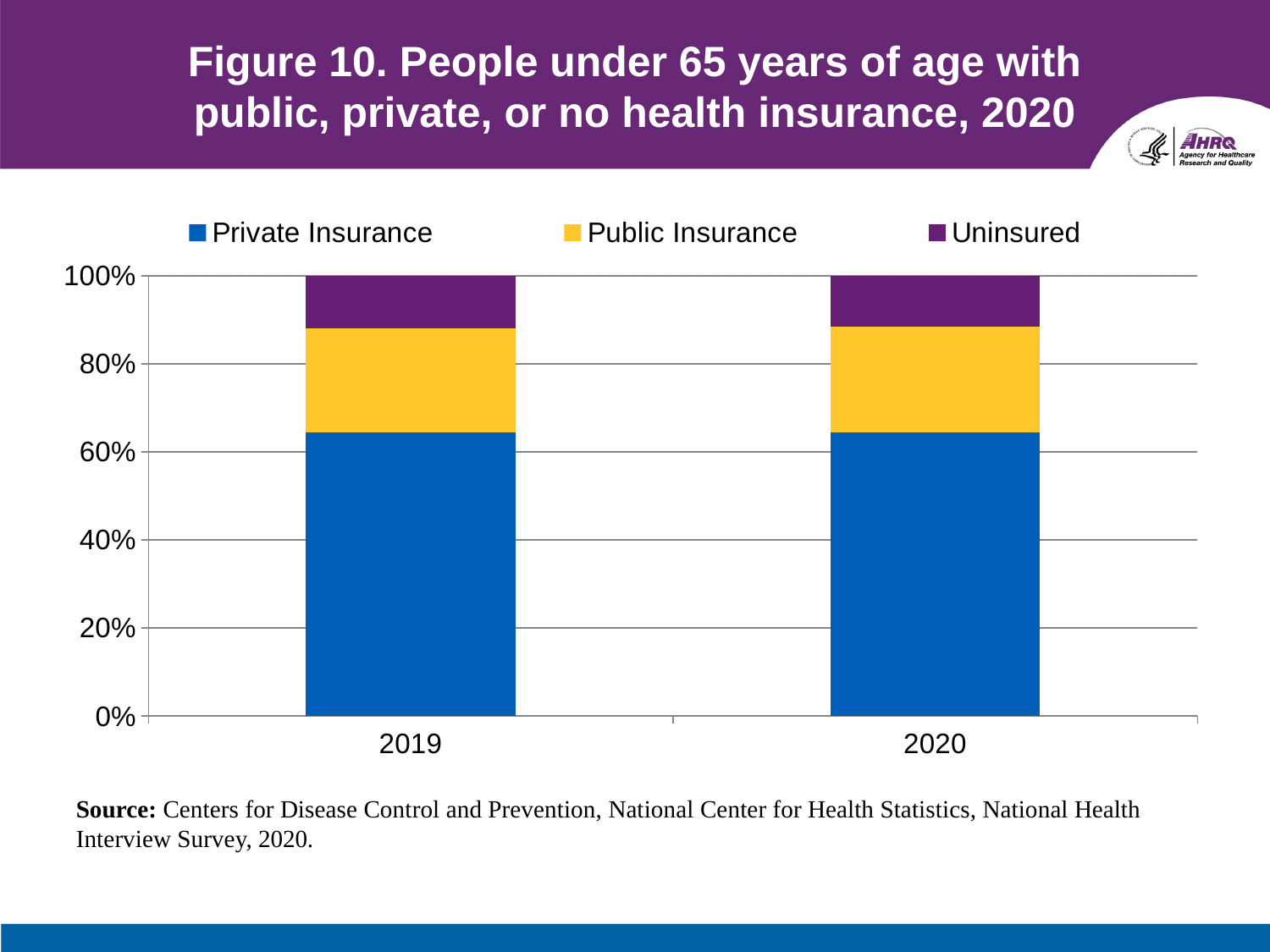
Is the value for Uninsured in 2020 greater or less than 20%? less In 2020, which is larger: Public Insurance or Uninsured? Public Insurance Which series are listed in the chart's legend? Private Insurance, Public Insurance, Uninsured Is the value for Private Insurance in 2019 greater or less than 60%? greater Is the value for Private Insurance in 2020 greater or less than 80%? less What kind of chart is shown on the slide? stacked bar chart How many years are shown on the x axis of the chart? 2 In 2019, which is larger: Private Insurance or Public Insurance? Private Insurance What is the title of the chart on the slide? Figure 10. People under 65 years of age with public, private, or no health insurance, 2020 How many series does the chart's legend list? 3 What is the total height of the stacked bar for 2020? 100%